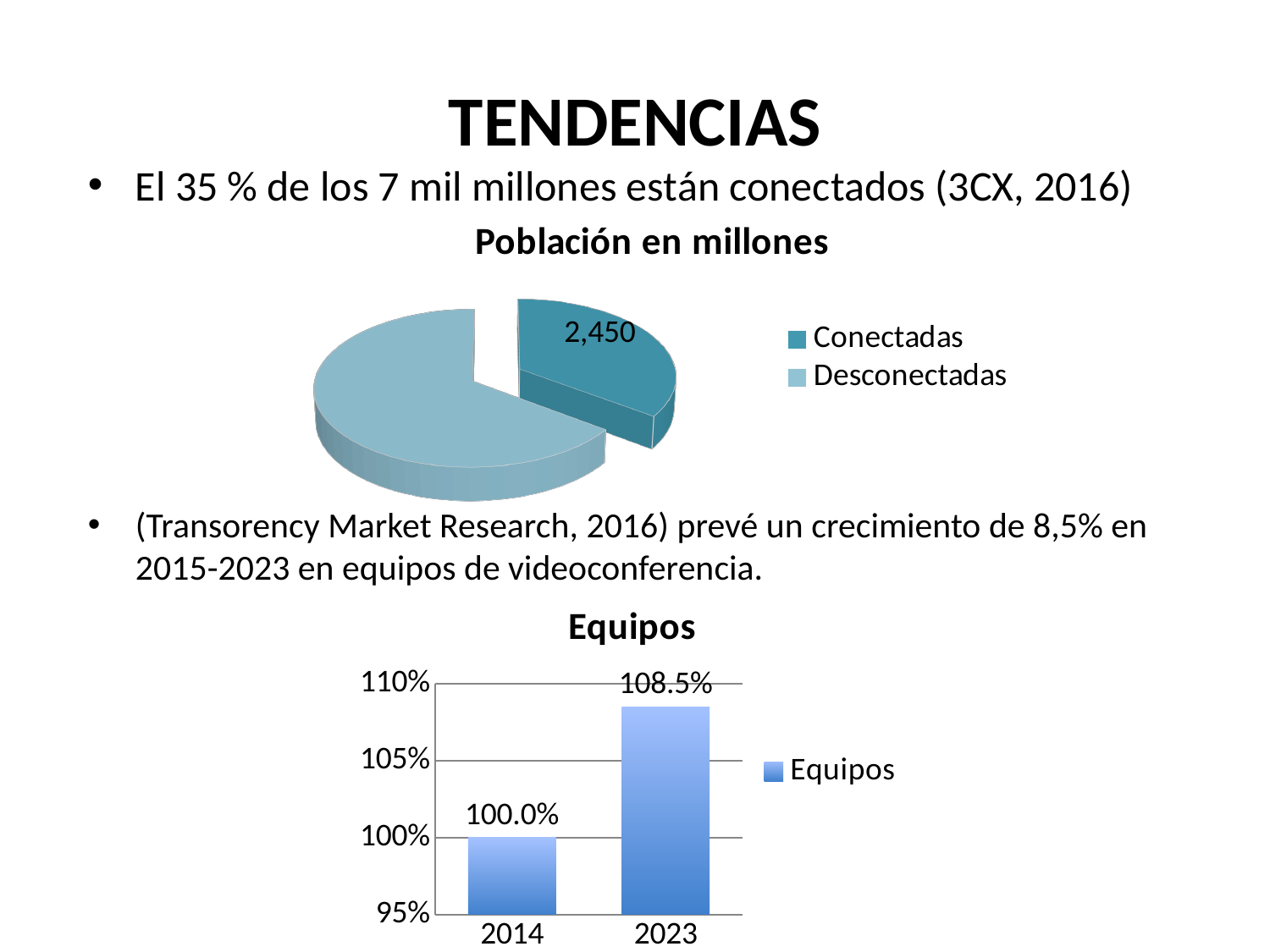
In the 'Población en millones' pie chart, what value is shown for Conectadas? 2,450 In the 'Equipos' chart, is the value for 2023 greater or less than 105%? greater In the 'Equipos' chart, what is the value for 2014? 100.0% In the 'Equipos' chart, do the values rise or fall from 2014 to 2023? Rise In the 'Equipos' chart, what is the difference between the 2023 and 2014 values? 8.5% How many categories are shown on the x axis of the 'Equipos' chart? 2 In the 'Equipos' chart, which year has the highest value? 2023 What kind of chart is 'Equipos'? Bar chart How many entries does the legend of the 'Población en millones' chart list? 2 In the 'Población en millones' pie chart, which slice is larger, Conectadas or Desconectadas? Desconectadas What kind of chart is 'Población en millones'? Pie chart In the 'Equipos' chart, what is the value for 2023? 108.5%